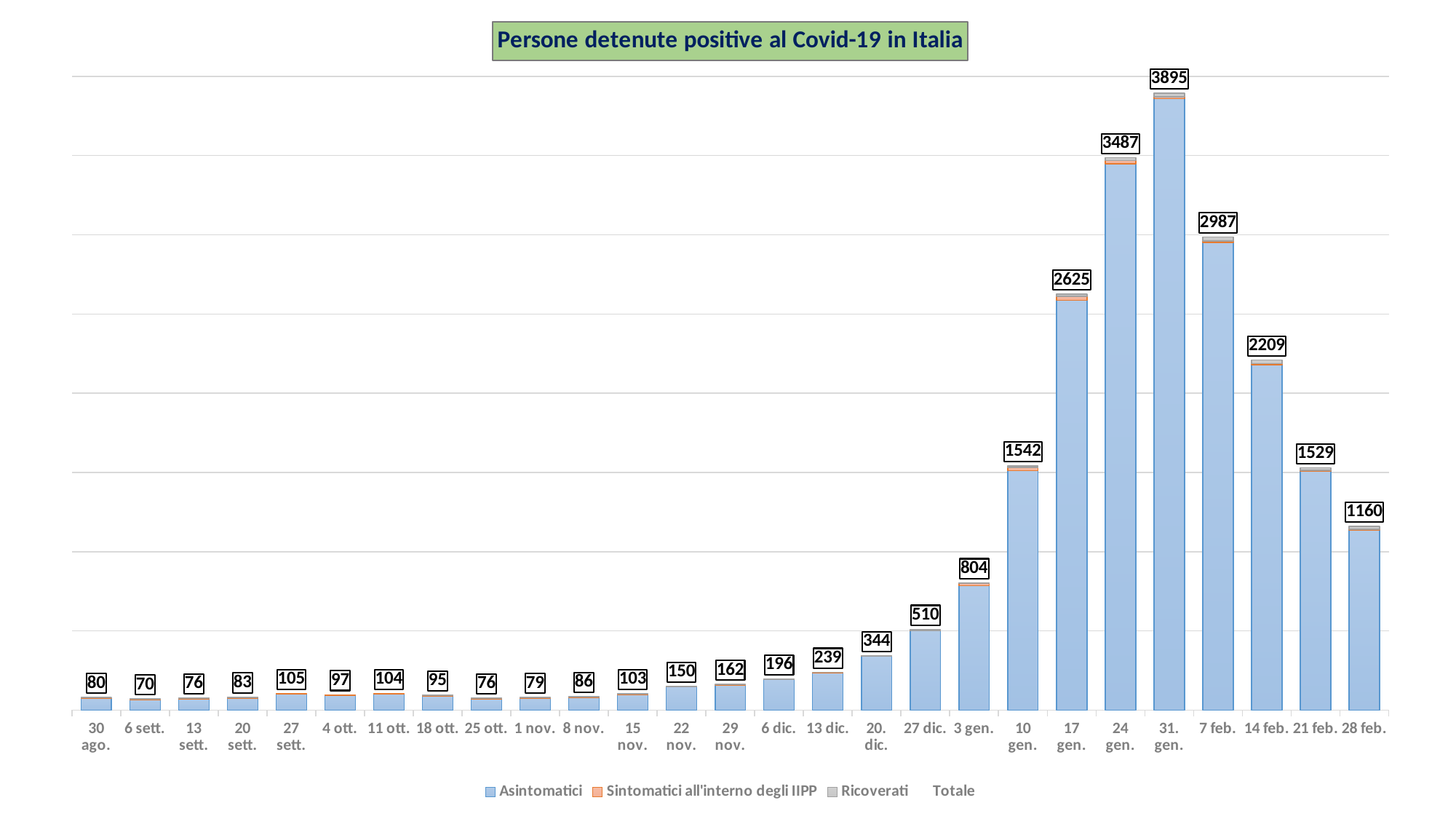
How many dates are shown on the x axis? 27 Which has a larger total, 17 gen. or 7 feb.? 7 feb. How many entries does the legend list? 4 What is the title of the chart? Persone detenute positive al Covid-19 in Italia What is the total number of positive detainees shown for 31 gen.? 3895 What total value is labelled for 27 dic.? 510 Which date has the lowest total? 6 sett. What is the difference between the totals for 31 gen. and 24 gen.? 408 What is the difference between the totals for 7 feb. and 14 feb.? 778 What kind of chart is this? Stacked bar chart What total value is labelled for 28 feb.? 1160 Which date has the highest total? 31 gen.